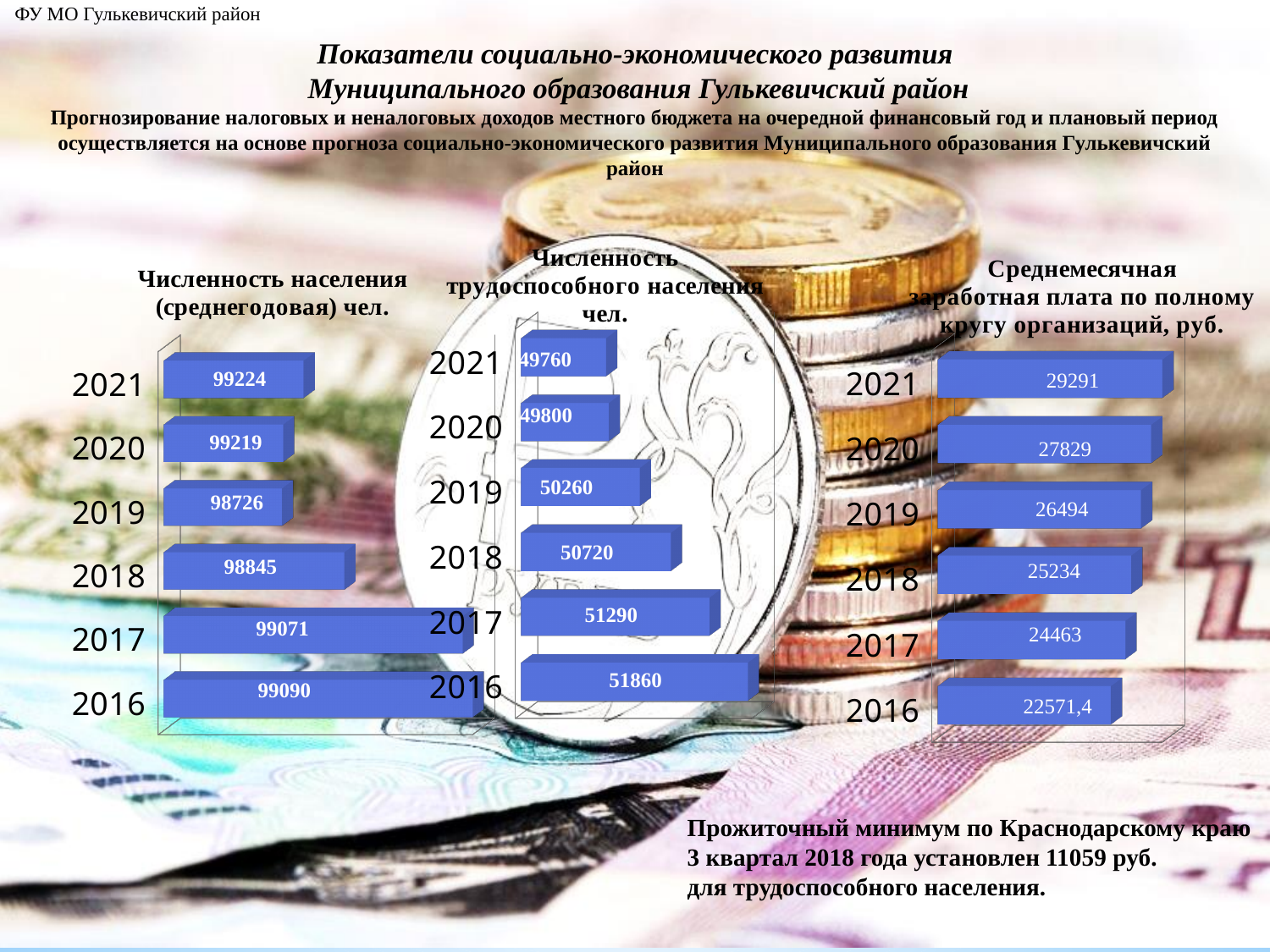
On the chart 'Численность трудоспособного населения чел.', do the values rise or fall from 2016 to 2021? fall On the chart 'Среднемесячная заработная плата по полному кругу организаций, руб.', what is the value for 2016? 22571,4 On the chart 'Численность трудоспособного населения чел.', which year has the highest value? 2016 On the chart 'Численность населения (среднегодовая) чел.', what is the value for 2019? 98726 On the chart 'Численность трудоспособного населения чел.', what is the value for 2018? 50720 How many years are shown on the chart 'Численность населения (среднегодовая) чел.'? 6 On the chart 'Среднемесячная заработная плата по полному кругу организаций, руб.', which year has the highest value? 2021 On the chart 'Среднемесячная заработная плата по полному кругу организаций, руб.', do the values rise or fall from 2016 to 2021? rise On the chart 'Численность трудоспособного населения чел.', what is the difference between the values for 2016 and 2021? 2100 On the chart 'Среднемесячная заработная плата по полному кругу организаций, руб.', what is the difference between the values for 2021 and 2020? 1462 On the chart 'Численность населения (среднегодовая) чел.', which year has the lowest value? 2019